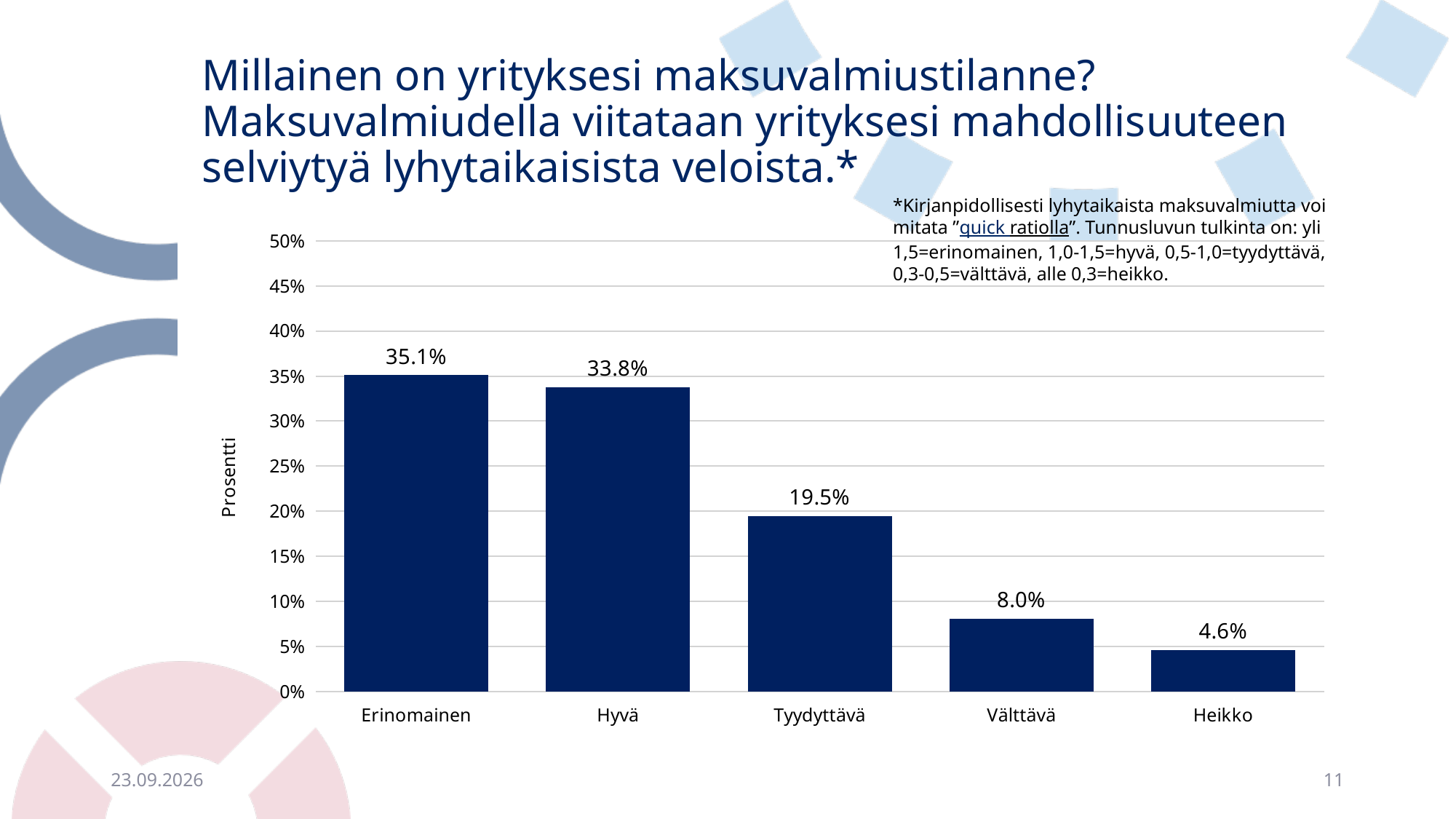
What is the value for Heikko? 4.6% What is the difference between the values for Hyvä and Tyydyttävä? 14.3% Which is larger, the value for Tyydyttävä or the value for Välttävä? Tyydyttävä Which category has the highest value? Erinomainen What is the difference between the values for Välttävä and Heikko? 3.4% What kind of chart is shown on the slide? bar chart How many categories are shown on the x axis? 5 What is the label of the y axis? Prosentti Is the value for Hyvä greater or less than 30%? greater What is the value for Tyydyttävä? 19.5% Which category has the lowest value? Heikko What is the value for Erinomainen? 35.1%